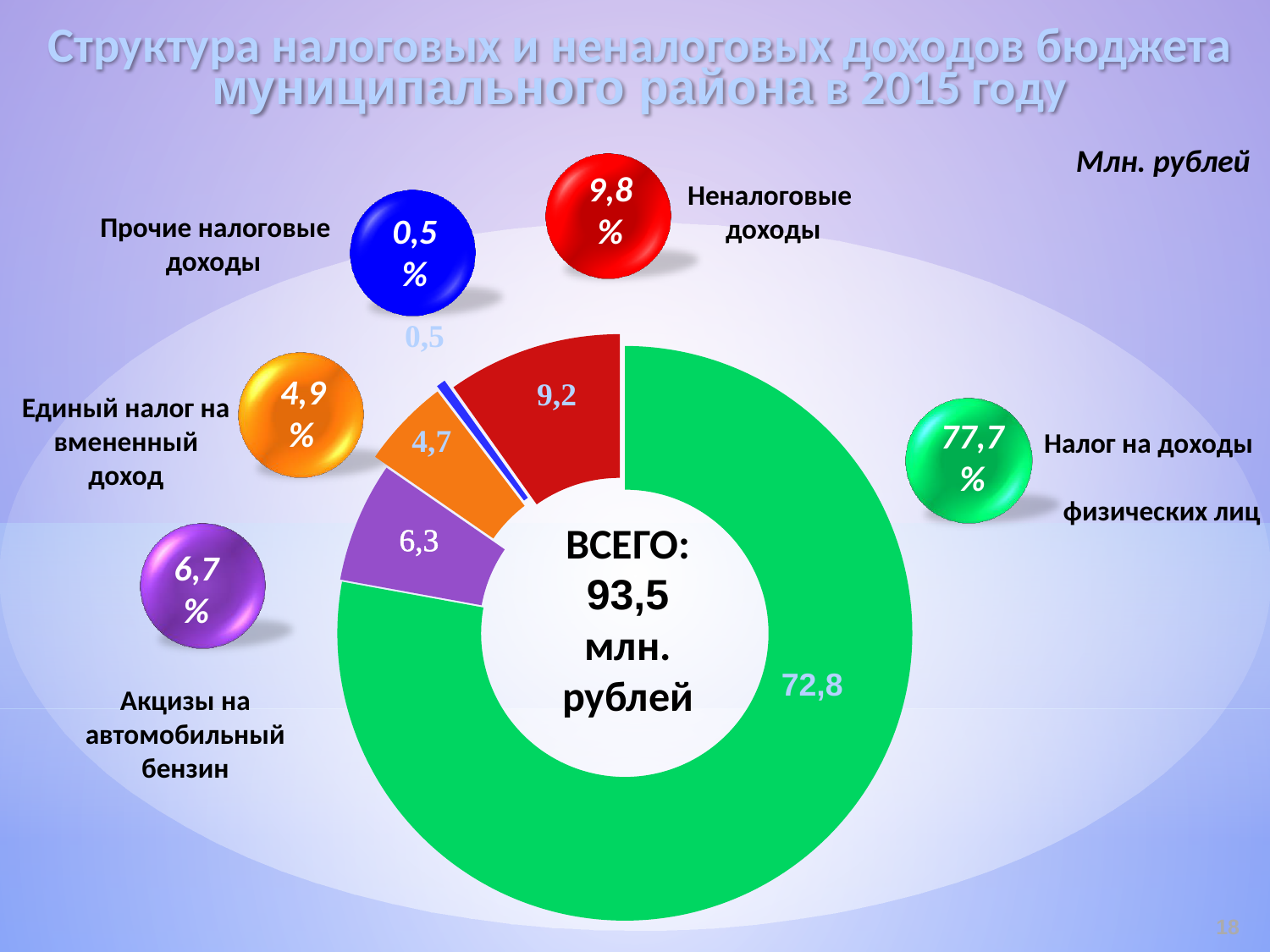
What is the value for Прочие налоговые доходы in the chart? 0,5 What is the value for Налог на доходы физических лиц in the chart? 72,8 What is the value for Единый налог на вмененный доход in the chart? 4,7 What is the difference between the values for Неналоговые доходы and Акцизы на автомобильный бензин? 2,9 What is the value for Неналоговые доходы in the chart? 9,2 What percentage share does Налог на доходы физических лиц have according to the slide? 77,7% What total is shown in the centre of the chart? 93,5 млн. рублей What kind of chart is shown on the slide? Doughnut (pie) chart What percentage share does Неналоговые доходы have according to the slide? 9,8% What is the value for Акцизы на автомобильный бензин in the chart? 6,3 Which category has the smallest share of the chart? Прочие налоговые доходы Which category has the largest share of the chart? Налог на доходы физических лиц